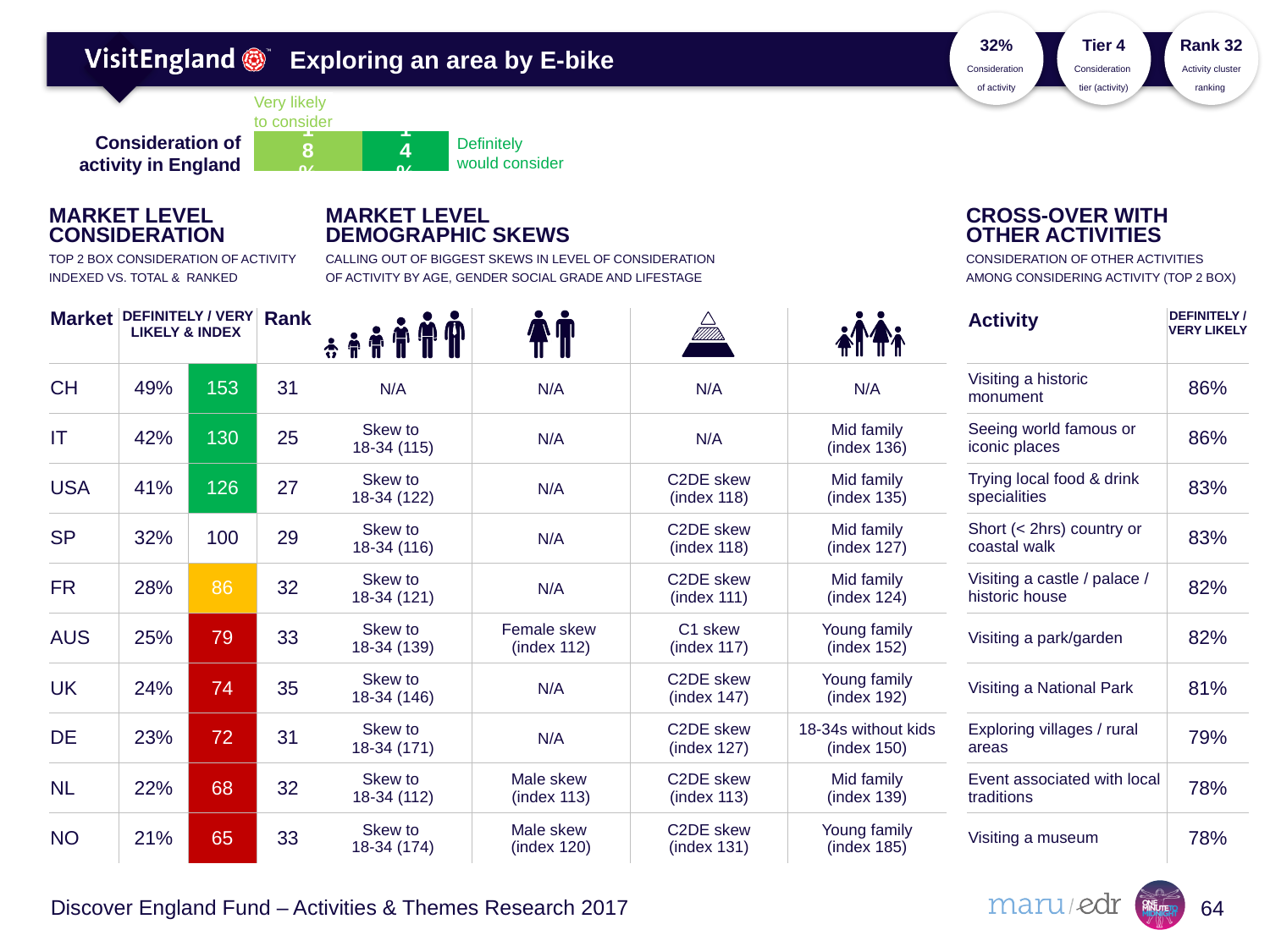
In the 'Consideration of activity in England' chart, what is the value for 'Very likely to consider'? 18% In the 'Consideration of activity in England' chart, what is the difference between 'Very likely to consider' and 'Definitely would consider'? 4% In the 'Consideration of activity in England' chart, which segment is larger: 'Very likely to consider' or 'Definitely would consider'? Very likely to consider In the 'Consideration of activity in England' chart, what is the total of the stacked bar? 32% In the 'Consideration of activity in England' chart, how many segments make up the bar? 2 In the 'Consideration of activity in England' chart, which segment is shown in the darker green colour? Definitely would consider In the 'Consideration of activity in England' chart, which segment appears on the left of the bar? Very likely to consider In the 'Consideration of activity in England' chart, what is the value for 'Definitely would consider'? 14% What kind of chart is the 'Consideration of activity in England' chart? Stacked bar chart